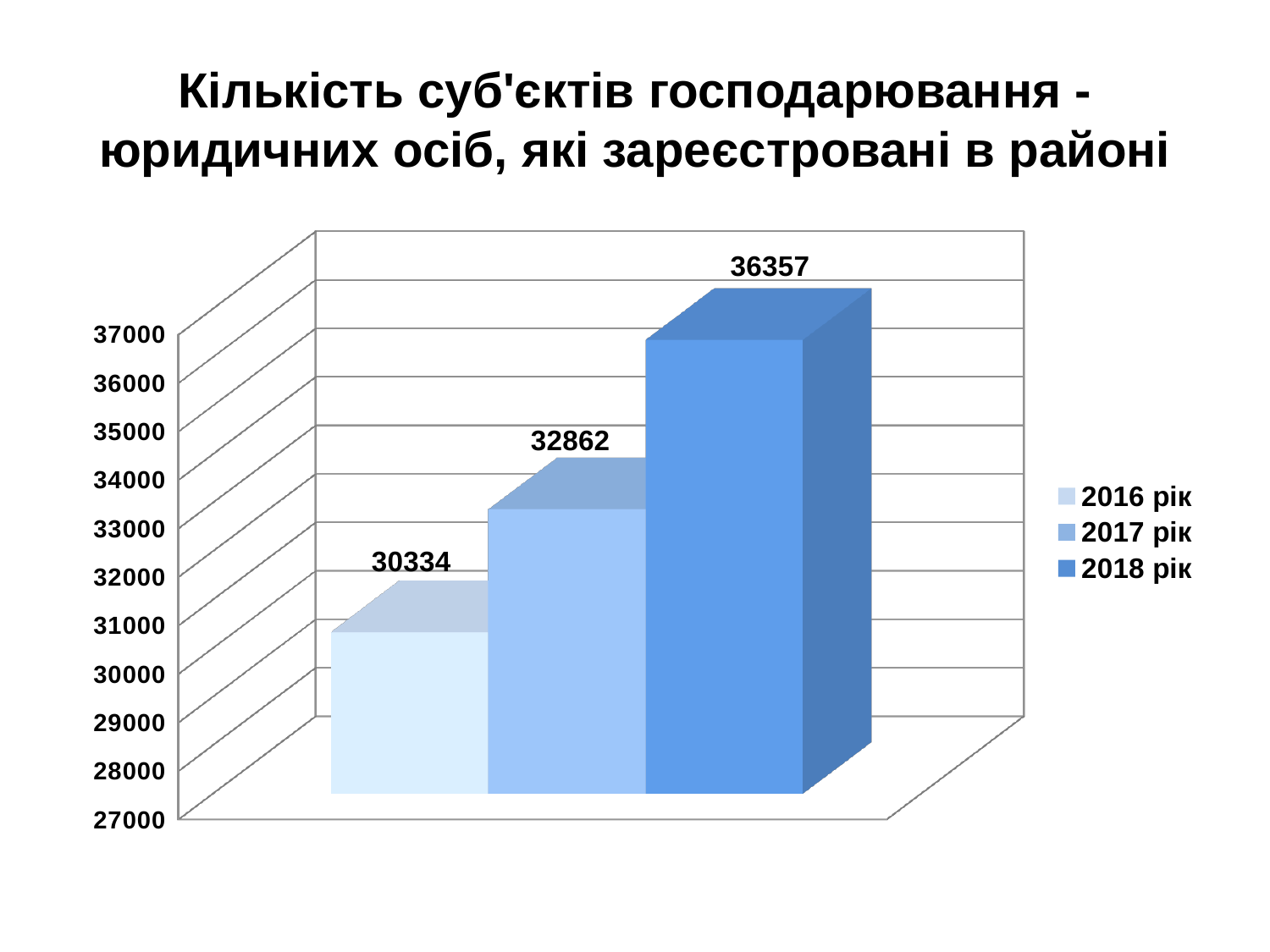
What is the difference between the values for 2017 рік and 2016 рік? 2528 Do the values rise or fall from 2016 рік to 2018 рік? rise What kind of chart is shown on the slide? bar chart How many series does the legend list? 3 What is the value for 2016 рік? 30334 What is the value for 2017 рік? 32862 Which is larger, the value for 2017 рік or the value for 2018 рік? 2018 рік Is the value for 2017 рік greater or less than 32000? greater Which year has the highest value? 2018 рік What is the value for 2018 рік? 36357 Which year has the lowest value? 2016 рік What is the difference between the values for 2018 рік and 2016 рік? 6023